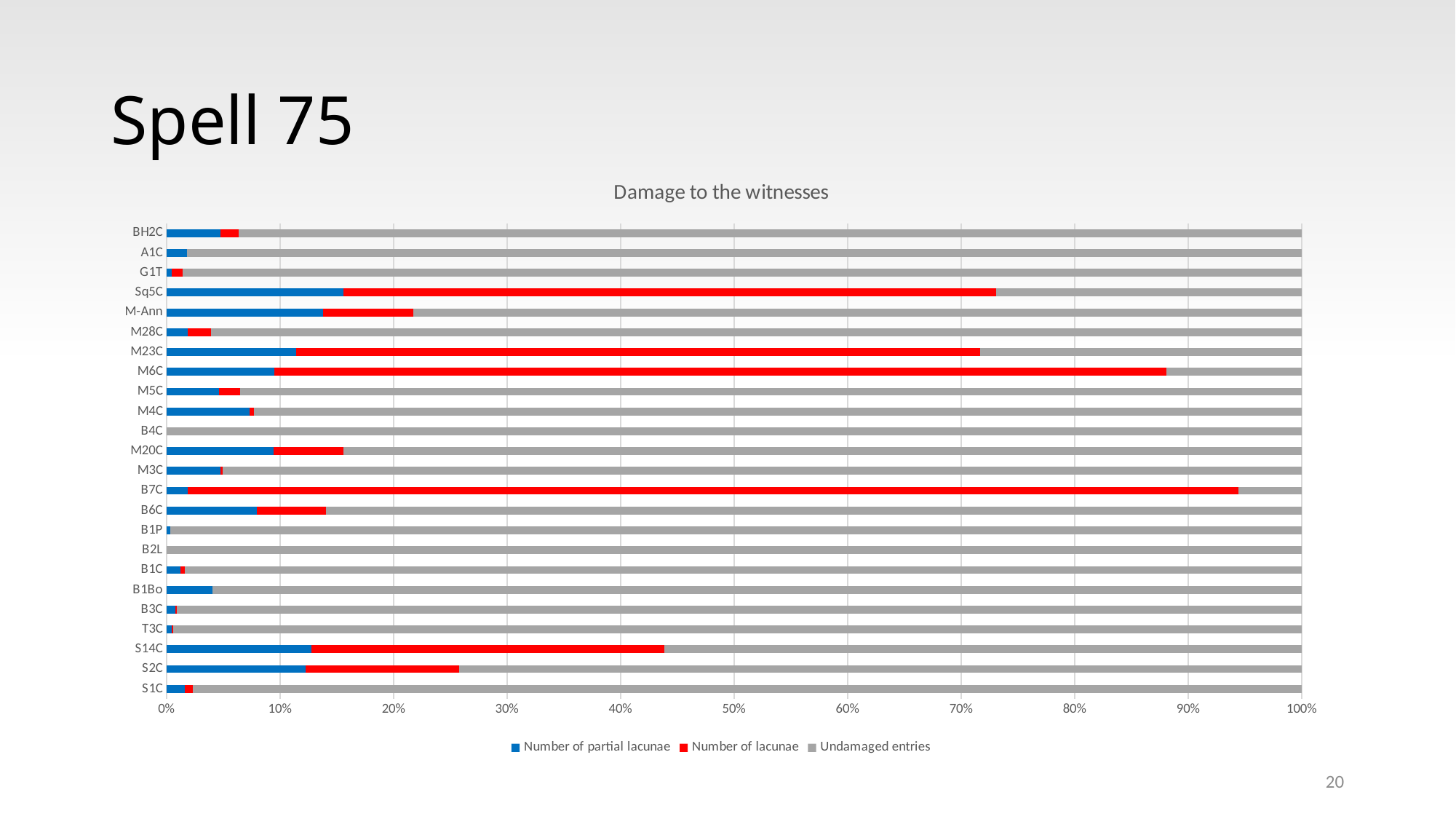
How many witnesses (categories) are plotted on the chart? 24 Is the 'Number of partial lacunae' share for Sq5C greater or less than 10%? greater What is the title of the chart? Damage to the witnesses Which witness has the largest share of 'Number of lacunae'? B7C Which has the larger 'Number of lacunae' share, S14C or S2C? S14C Is the 'Number of lacunae' share for B7C greater or less than 90%? greater Which has the larger 'Undamaged entries' share, B4C or B7C? B4C Is the 'Number of lacunae' share for S14C greater or less than 40%? less Which colour represents 'Number of lacunae' in the chart? red How many series does the legend list? 3 What kind of chart is shown on the slide? bar chart